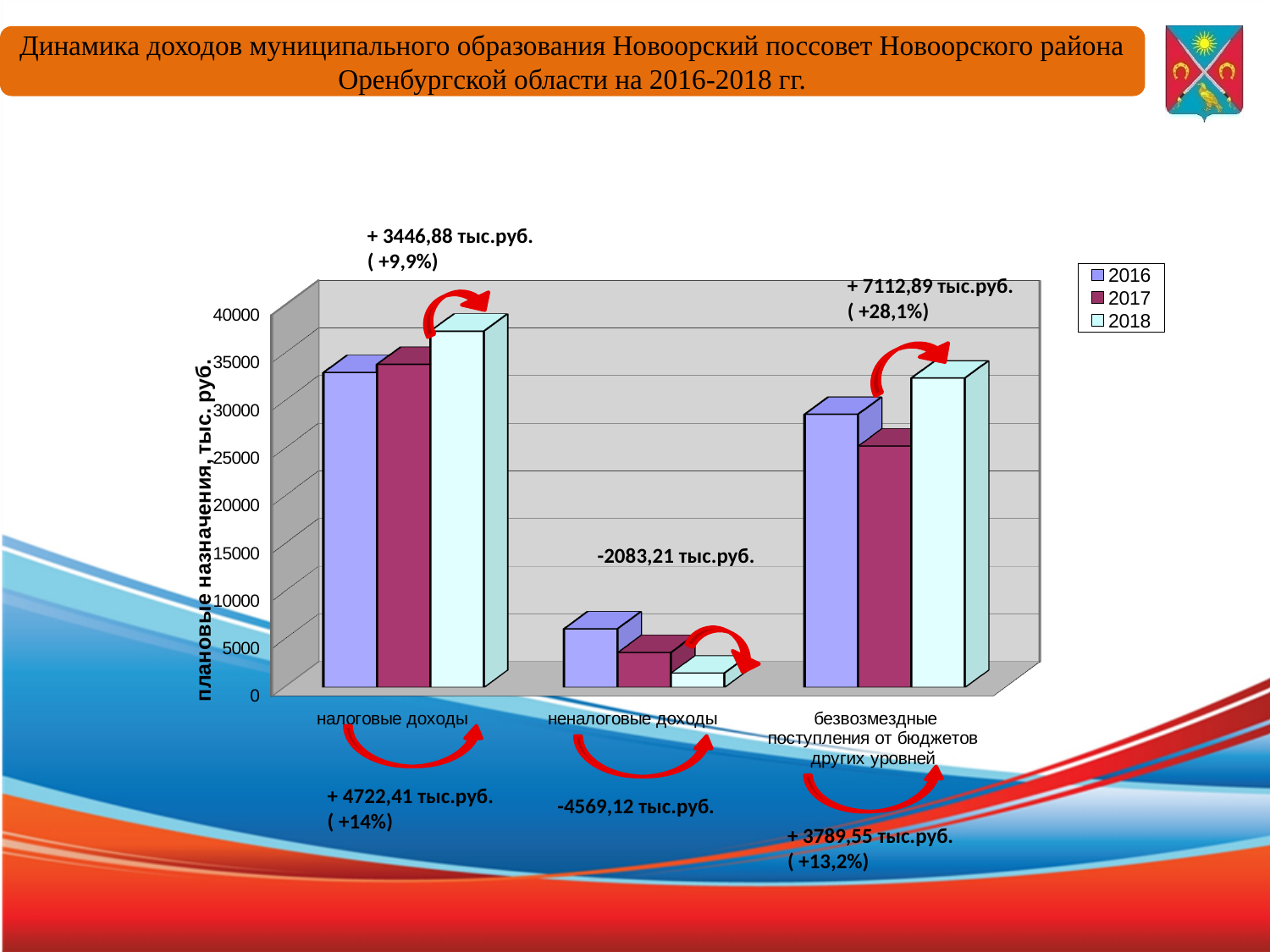
Do the values for неналоговые доходы rise or fall from 2016 to 2018? fall Which is larger in 2018: налоговые доходы or безвозмездные поступления от бюджетов других уровней? налоговые доходы Is the 2018 value for налоговые доходы greater or less than 35000? greater How many series does the legend list? 3 Is the 2018 value for неналоговые доходы greater or less than 5000? less Which category has the lowest values across all three years? неналоговые доходы Which years are listed in the legend? 2016, 2017, 2018 Do the values for налоговые доходы rise or fall from 2016 to 2018? rise What is the label of the vertical axis? плановые назначения, тыс. руб. Which category has the highest value for 2018? налоговые доходы What kind of chart is shown on the slide? bar chart How many categories are shown on the x axis? 3